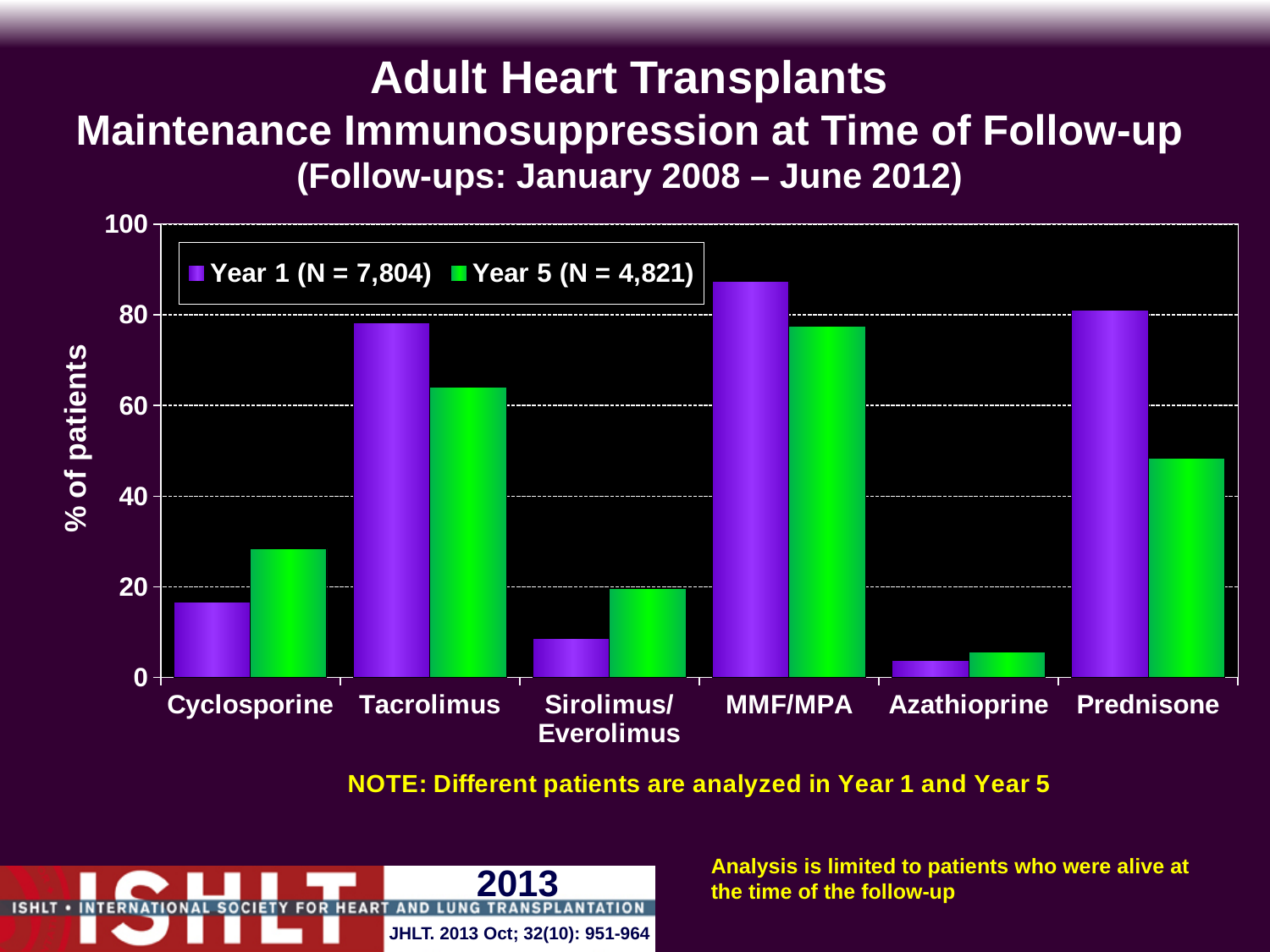
How many series does the legend list? 2 Which drug has the lowest Year 1 percentage of patients? Azathioprine What kind of chart is shown on the slide? Bar chart For Cyclosporine, which is larger: the Year 1 value or the Year 5 value? Year 5 For Prednisone, which is larger: the Year 1 value or the Year 5 value? Year 1 Which drug has the highest Year 5 percentage of patients? MMF/MPA How many drug categories are shown on the x axis? 6 Which drug has the highest Year 1 percentage of patients? MMF/MPA What is the label of the y axis? % of patients Is the Year 5 value for Prednisone greater or less than 60? less Is the Year 1 value for Tacrolimus greater or less than 60? greater Is the Year 1 value for MMF/MPA greater or less than 80? greater